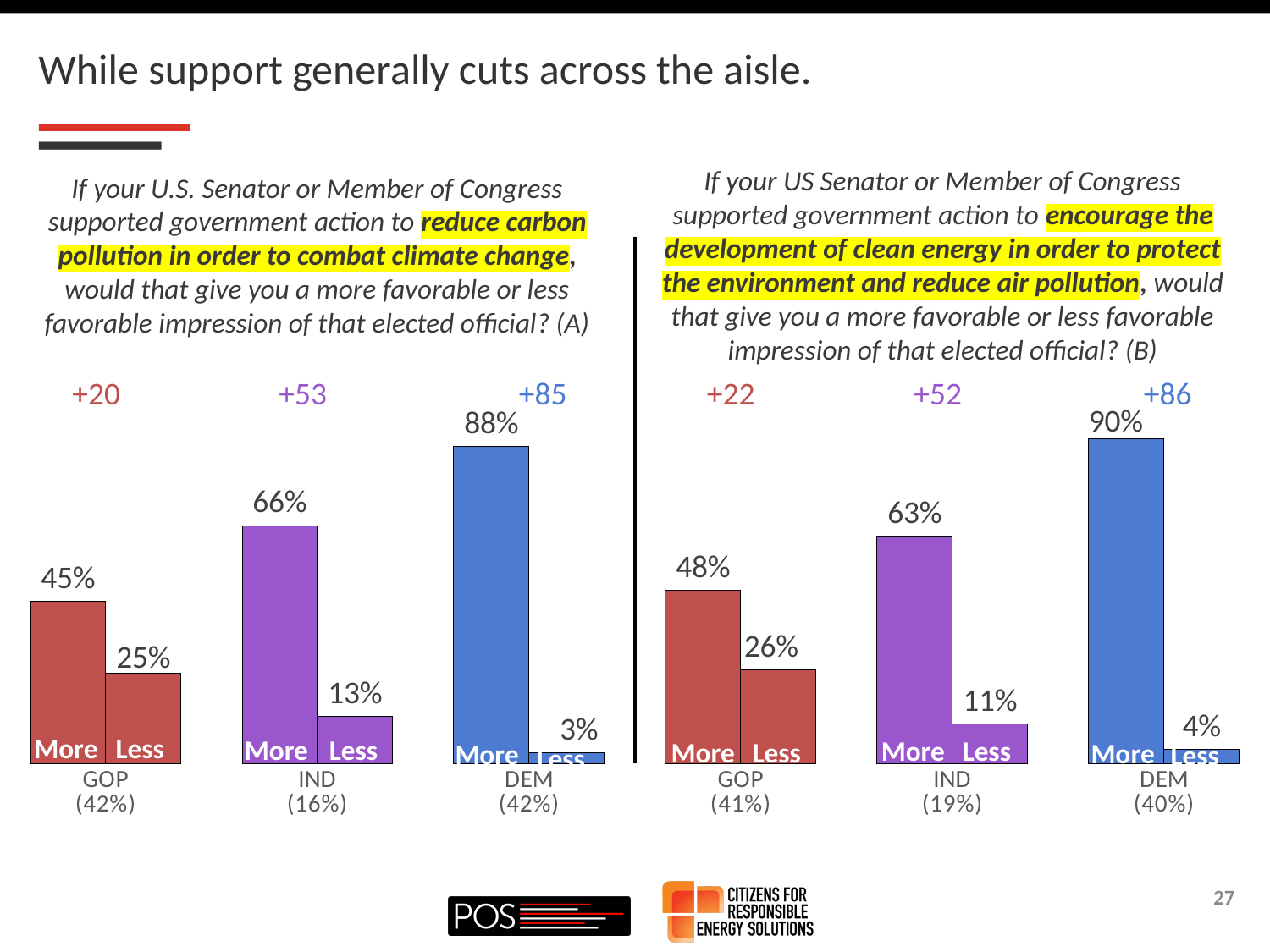
In the right chart (question B), what percentage of IND respondents said 'More' favorable? 63% How many party groups are shown in the left chart (question A)? 3 Is the 'More' favorable percentage for GOP respondents larger in the left chart (question A) or the right chart (question B)? Right chart (question B) In the right chart (question B), what percentage of GOP respondents said 'Less' favorable? 26% In the left chart (question A), what is the difference between the 'More' and 'Less' percentages for IND respondents? 53 percentage points What type of chart is used on this slide? Bar chart In the right chart (question B), what net score is shown above the DEM bars? +86 In the left chart (question A), what percentage of GOP respondents said 'More' favorable? 45% In the left chart (question A), what percentage of DEM respondents said 'Less' favorable? 3% In the right chart (question B), what is the difference between the DEM 'More' percentage and the GOP 'More' percentage? 42 percentage points In the right chart (question B), which party group has the lowest 'Less' favorable percentage? DEM In the left chart (question A), which party group has the highest 'More' favorable percentage? DEM